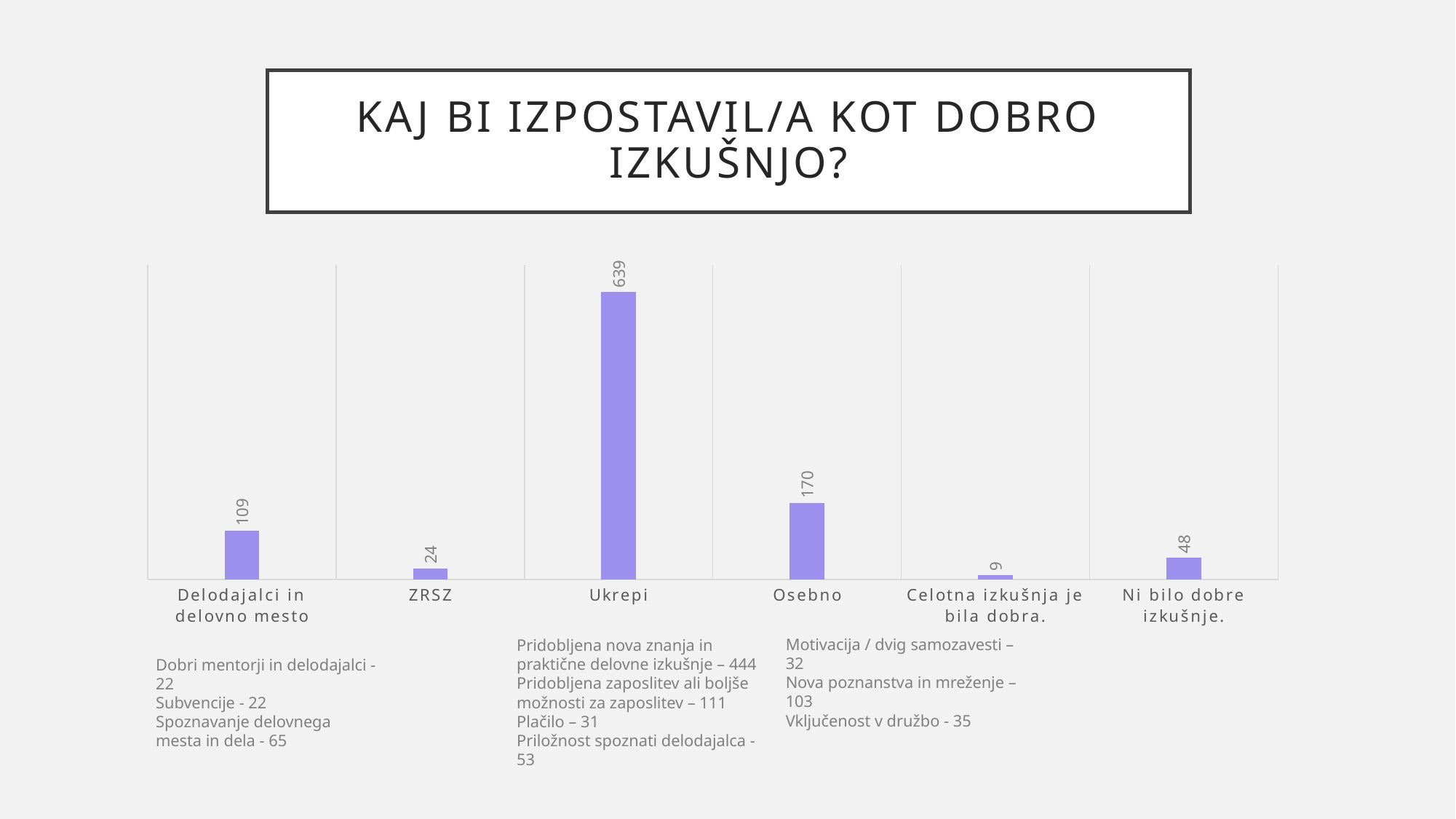
What is the difference between the values for Ukrepi and Osebno? 469 Which category has the lowest value? Celotna izkušnja je bila dobra. How many categories are shown in the chart? 6 What is the value for Osebno? 170 Which category has the highest value? Ukrepi Which is larger, the value for Osebno or the value for Delodajalci in delovno mesto? Osebno What is the value for Ni bilo dobre izkušnje.? 48 What is the difference between the values for Delodajalci in delovno mesto and ZRSZ? 85 What kind of chart is shown on the slide? bar chart What is the value for Ukrepi? 639 What is the value for Delodajalci in delovno mesto? 109 What is the value for ZRSZ? 24